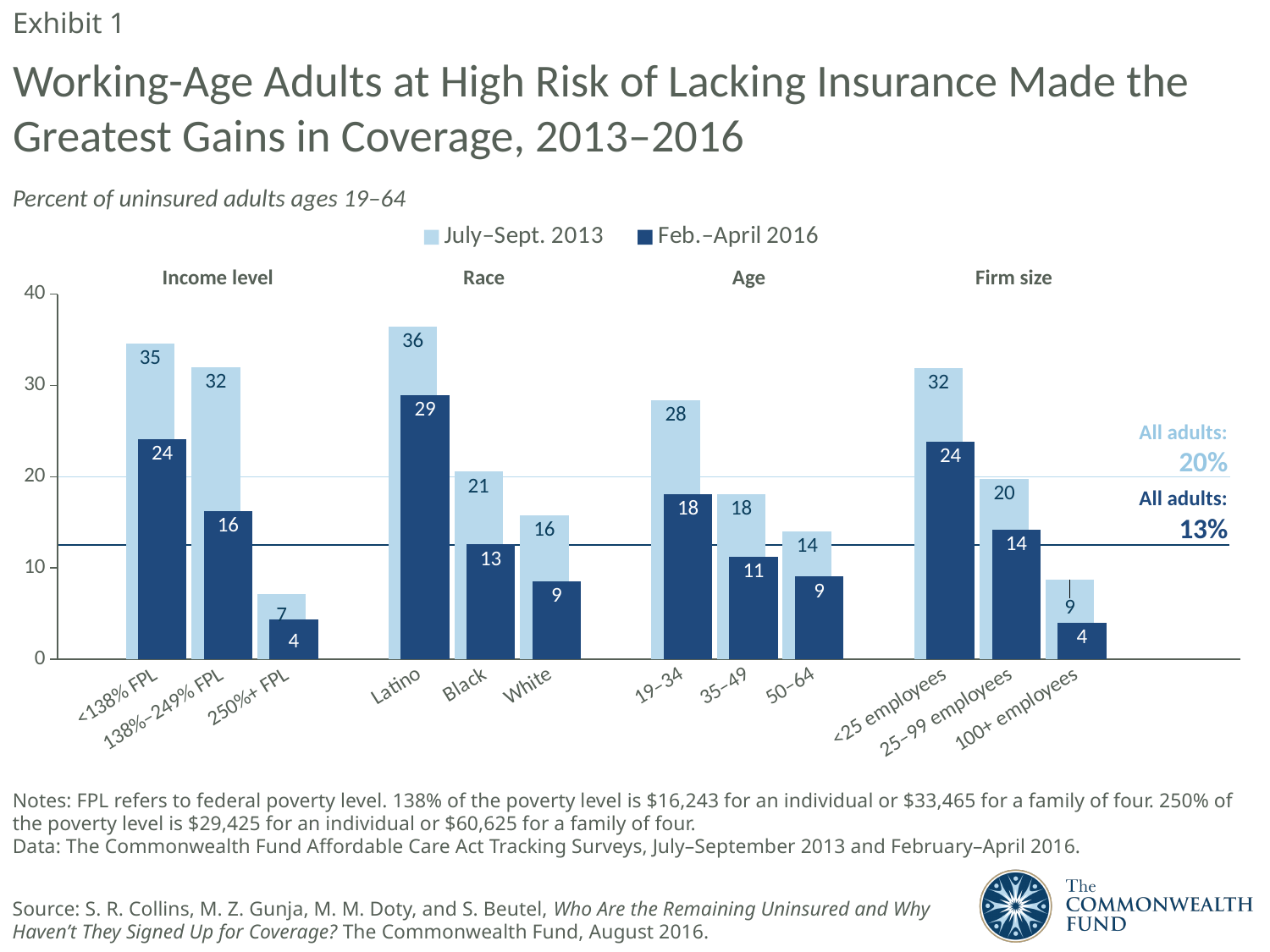
How many categories are shown on the x axis? 12 Which category had the lowest percent uninsured in July–Sept. 2013? 250%+ FPL What kind of chart is shown on the slide? Bar chart Which category had the highest percent uninsured in July–Sept. 2013? Latino What is the 'All adults' value shown for Feb.–April 2016? 13% What was the percent of uninsured adults for 25–99 employees in July–Sept. 2013? 20 What is the difference between the July–Sept. 2013 and Feb.–April 2016 values for <138% FPL? 11 Within the Age group, do the Feb.–April 2016 values rise or fall from 19–34 to 50–64? Fall Which is larger: the Feb.–April 2016 value for Black or the Feb.–April 2016 value for 35–49? Black What was the percent of uninsured adults for 138%–249% FPL in Feb.–April 2016? 16 What was the percent of uninsured adults for Latino in July–Sept. 2013? 36 How many series does the legend list? 2